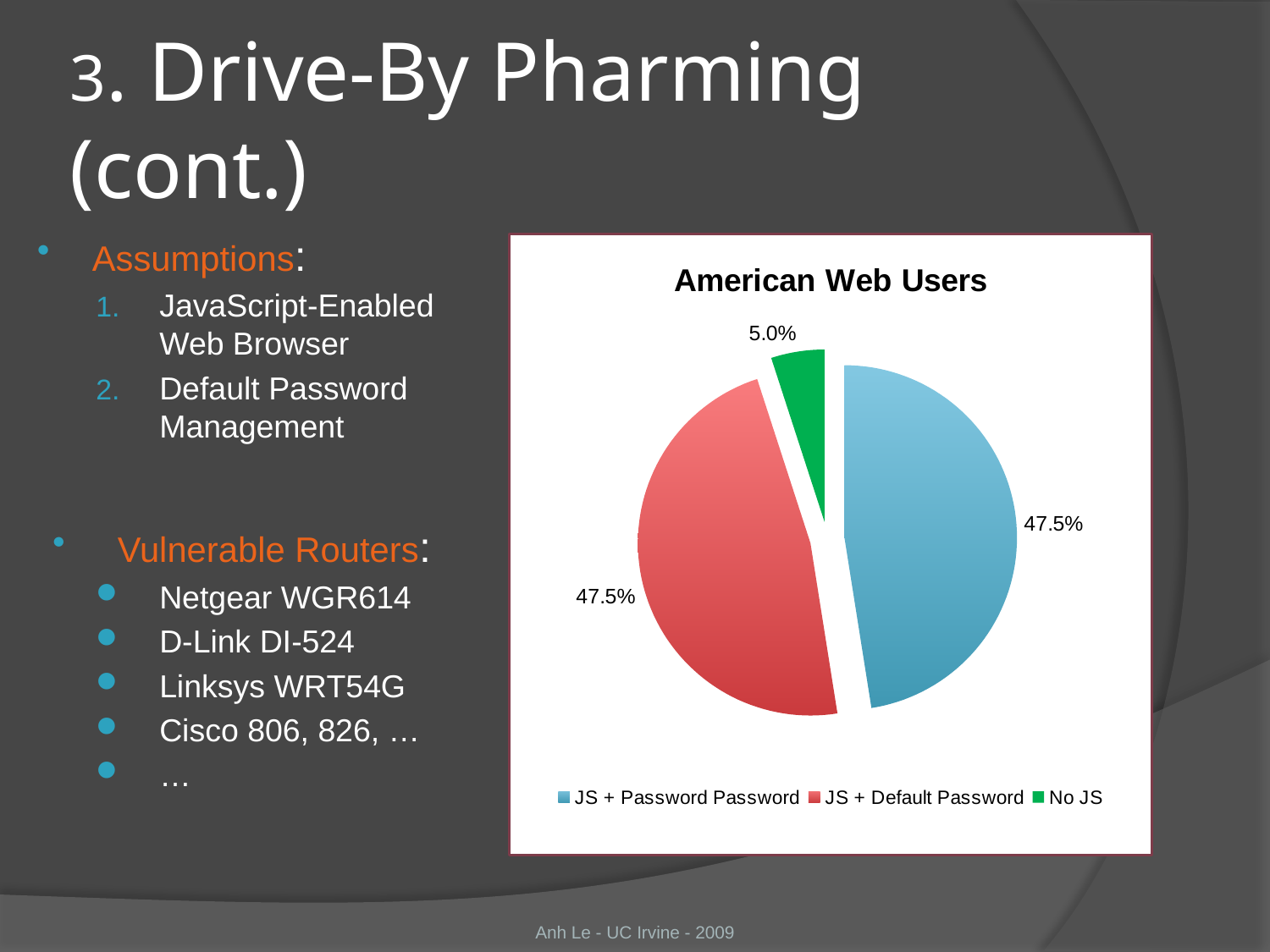
What is the difference between the "JS + Default Password" share and the "No JS" share? 42.5% What share of the pie is labelled "JS + Default Password"? 47.5% Which slice of the pie is the smallest? No JS What is the title of the chart? American Web Users Which is larger, the "JS + Password Password" slice or the "No JS" slice? JS + Password Password What kind of chart is shown on the slide? pie chart What colour is the "No JS" slice? green How many entries does the legend list? 3 What is the combined share of the two slices labelled 47.5%? 95.0% What share of the pie is labelled "No JS"? 5.0% What share of the pie is labelled "JS + Password Password"? 47.5% How many slices does the pie chart have? 3